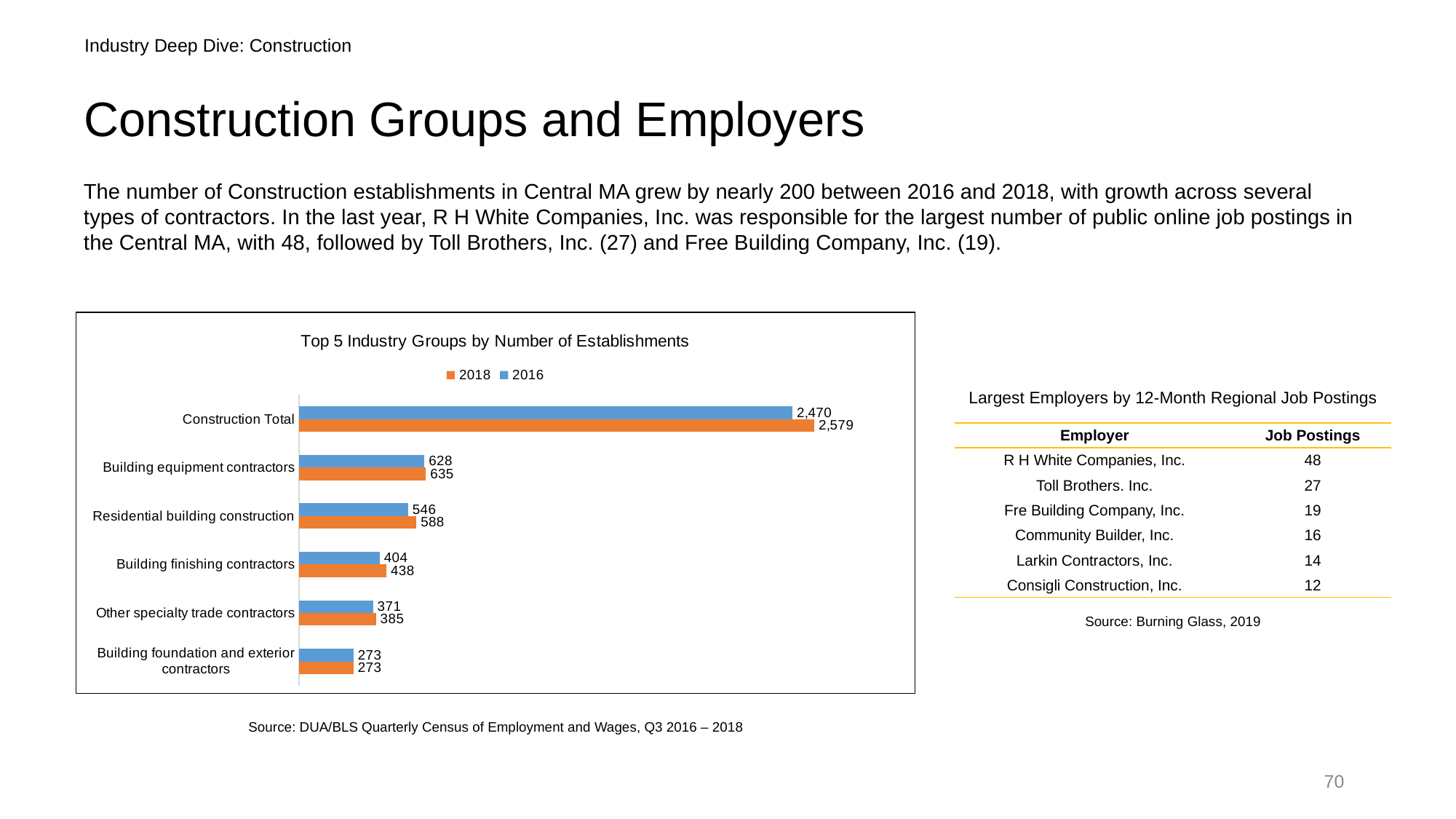
What is the 2016 value for Residential building construction? 546 Which category has the lowest 2016 value in the chart? Building foundation and exterior contractors What is the 2016 value for Other specialty trade contractors? 371 For Building finishing contractors, which year has the larger value, 2016 or 2018? 2018 How many series does the chart legend list? 2 What is the difference between the 2018 and 2016 values for Construction Total? 109 What is the 2018 value for Construction Total in the 'Top 5 Industry Groups by Number of Establishments' chart? 2,579 What is the 2018 value for Building finishing contractors? 438 What is the difference between the 2018 and 2016 values for Residential building construction? 42 What type of chart is 'Top 5 Industry Groups by Number of Establishments'? Bar chart How many categories are shown on the y axis of the chart? 6 Excluding Construction Total, which industry group has the highest number of establishments in 2018? Building equipment contractors